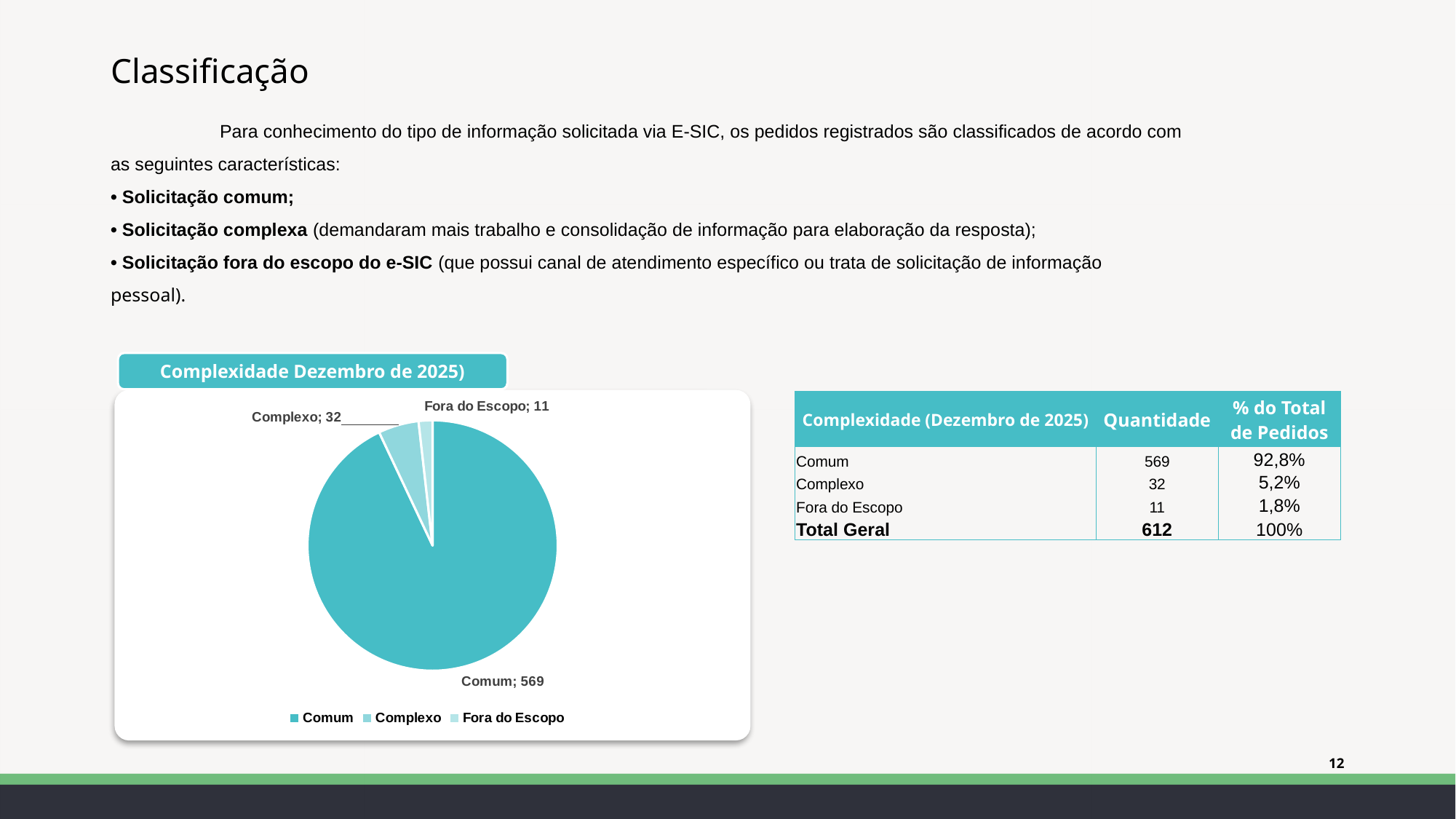
What is the title of the pie chart? Complexidade Dezembro de 2025) What is the value for Comum in the pie chart? 569 What is the difference between the values for Complexo and Fora do Escopo in the pie chart? 21 What type of chart is shown on the slide? pie chart What is the total of all slices in the pie chart? 612 Which is larger in the pie chart, Complexo or Fora do Escopo? Complexo Which category has the largest slice in the pie chart? Comum What is the value for Complexo in the pie chart? 32 What is the difference between the values for Comum and Complexo in the pie chart? 537 Which category has the smallest slice in the pie chart? Fora do Escopo How many categories does the pie chart show? 3 What is the value for Fora do Escopo in the pie chart? 11